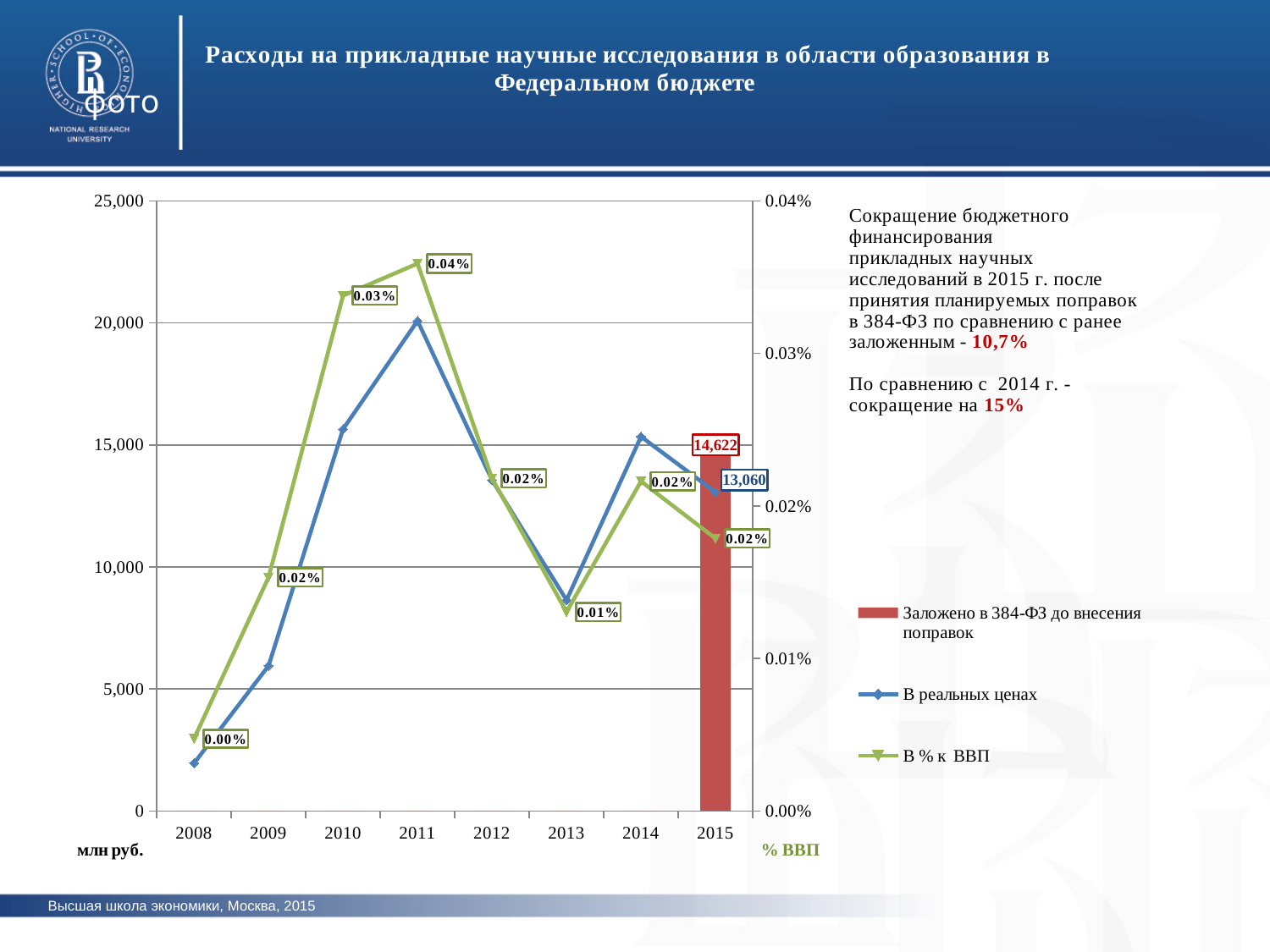
In which year is the 'В % к ВВП' series lowest? 2008 How many years are shown on the x axis? 8 Is the 'В реальных ценах' value for 2011 greater or less than 15,000? greater What is the value of the 'В реальных ценах' series in 2015? 13,060 What is the value of the 'В % к ВВП' series in 2011? 0.04% How many series does the legend list? 3 Does the 'В реальных ценах' series rise or fall from 2008 to 2011? rise What is the value of the 'Заложено в 384-ФЗ до внесения поправок' bar for 2015? 14,622 What is the value of the 'В % к ВВП' series in 2013? 0.01% In which year is the 'В % к ВВП' series highest? 2011 For 2015, which is larger: the 'Заложено в 384-ФЗ до внесения поправок' bar or the 'В реальных ценах' value? Заложено в 384-ФЗ до внесения поправок What is the difference between the 2015 'Заложено в 384-ФЗ до внесения поправок' bar (14,622) and the 2015 'В реальных ценах' value (13,060)? 1,562